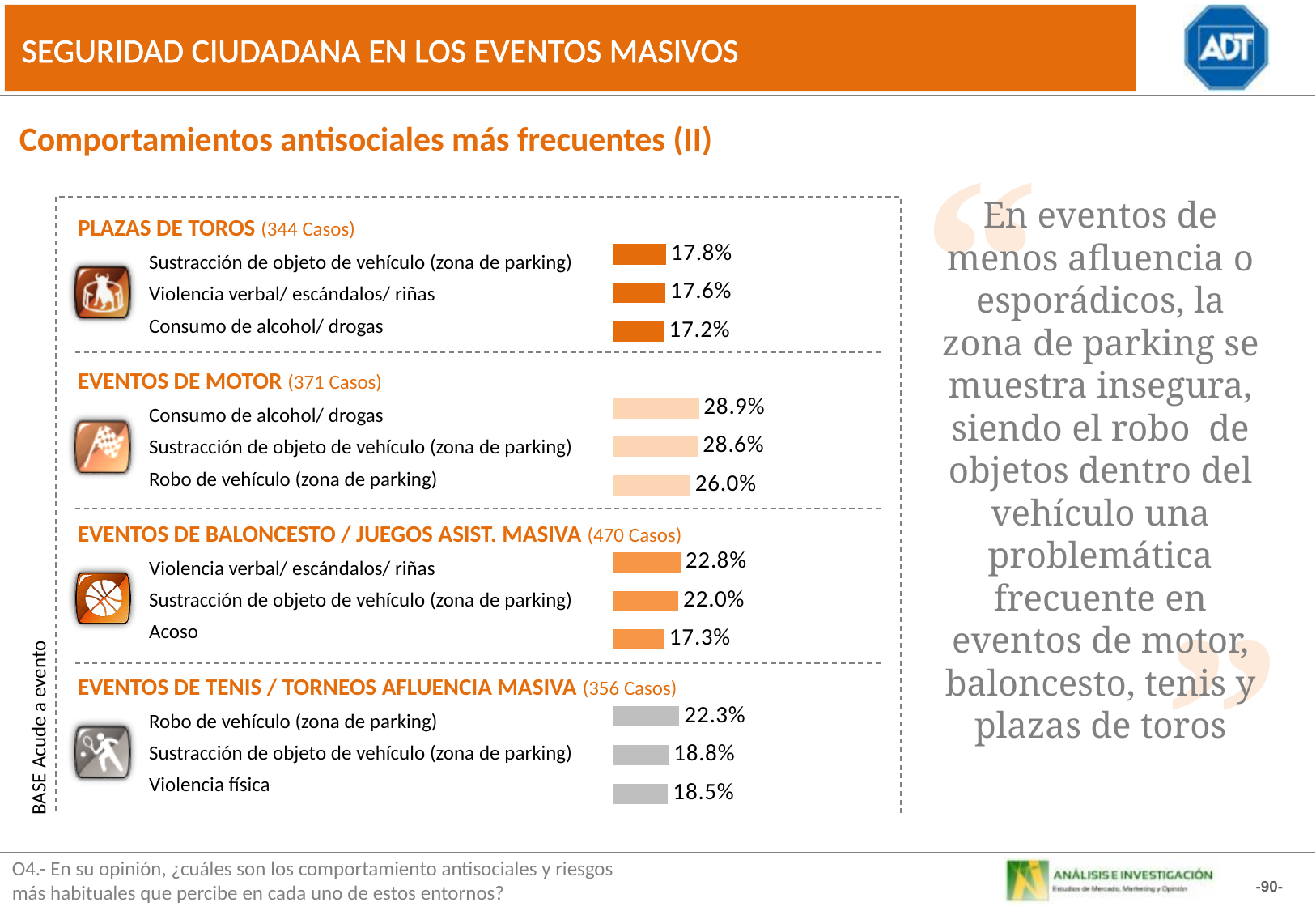
In the EVENTOS DE BALONCESTO / JUEGOS ASIST. MASIVA chart, what is the difference between Violencia verbal/ escándalos/ riñas and Acoso? 5.5% What kind of chart is used in the PLAZAS DE TOROS section? Bar chart In the EVENTOS DE MOTOR chart, which category has the highest value? Consumo de alcohol/ drogas In the EVENTOS DE BALONCESTO / JUEGOS ASIST. MASIVA chart, which category has the lowest value? Acoso In the PLAZAS DE TOROS chart, which is larger: Sustracción de objeto de vehículo (zona de parking) or Consumo de alcohol/ drogas? Sustracción de objeto de vehículo (zona de parking) In the EVENTOS DE BALONCESTO / JUEGOS ASIST. MASIVA chart, what is the value for Acoso? 17.3% How many cases (Casos) are indicated for the EVENTOS DE BALONCESTO / JUEGOS ASIST. MASIVA chart? 470 Casos In the EVENTOS DE MOTOR chart, what is the value for Robo de vehículo (zona de parking)? 26.0% How many categories are shown in the EVENTOS DE MOTOR chart? 3 In the EVENTOS DE TENIS / TORNEOS AFLUENCIA MASIVA chart, what is the difference between Robo de vehículo (zona de parking) and Violencia física? 3.8% In the PLAZAS DE TOROS chart, what is the value for Sustracción de objeto de vehículo (zona de parking)? 17.8% In the EVENTOS DE TENIS / TORNEOS AFLUENCIA MASIVA chart, what is the value for Violencia física? 18.5%